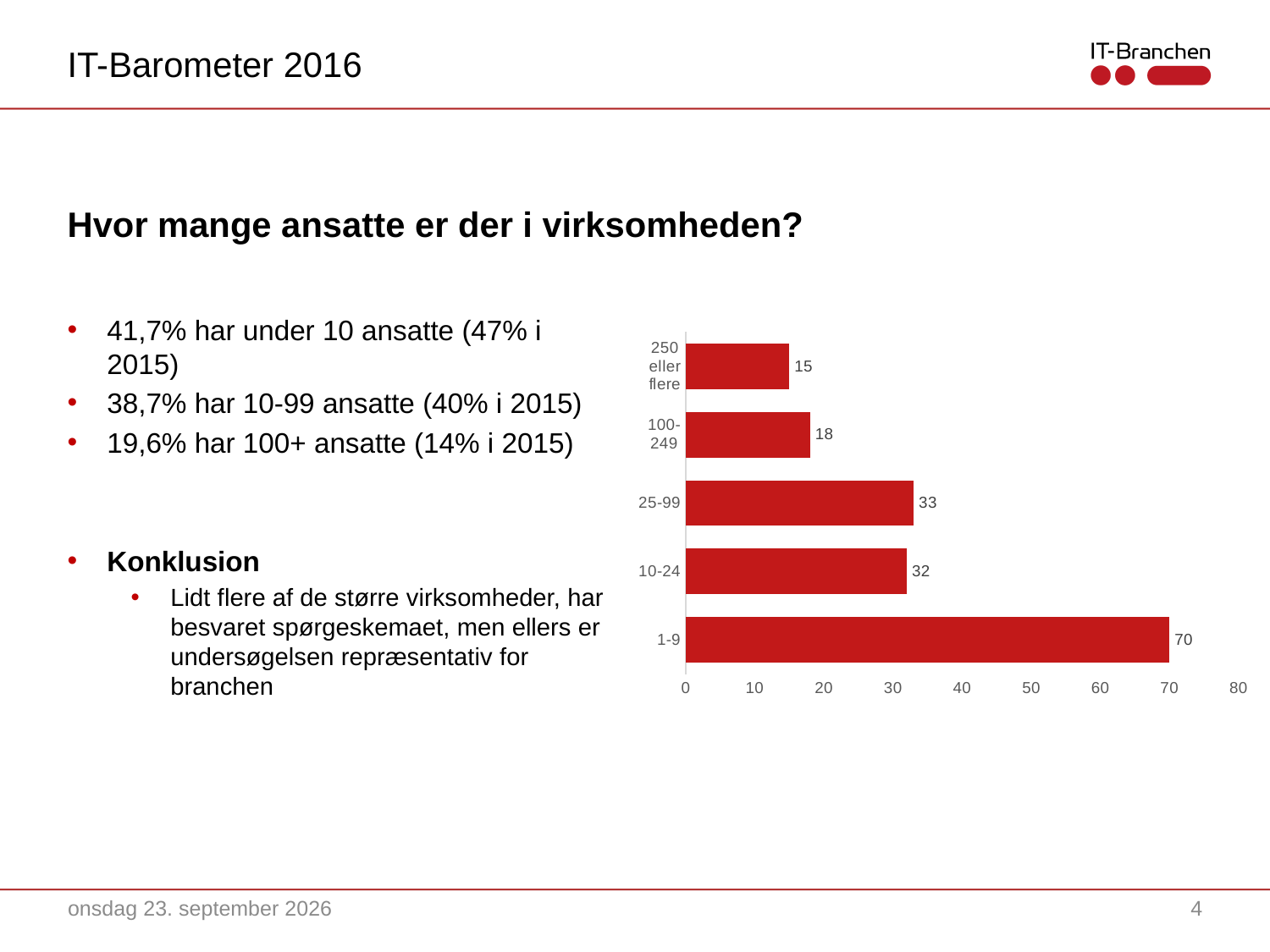
Which is larger, the value for 10-24 or the value for 100-249? 10-24 What kind of chart is shown on the slide? bar chart How many categories are shown in the chart? 5 What is the value for the 1-9 category? 70 What is the value for the 250 eller flere category? 15 What is the difference between the values for 100-249 and 250 eller flere? 3 Is the value for 25-99 greater or less than 40? less Which category has the lowest value? 250 eller flere What is the difference between the values for 1-9 and 10-24? 38 What is the value for the 25-99 category? 33 What is the value for the 100-249 category? 18 Which category has the highest value? 1-9